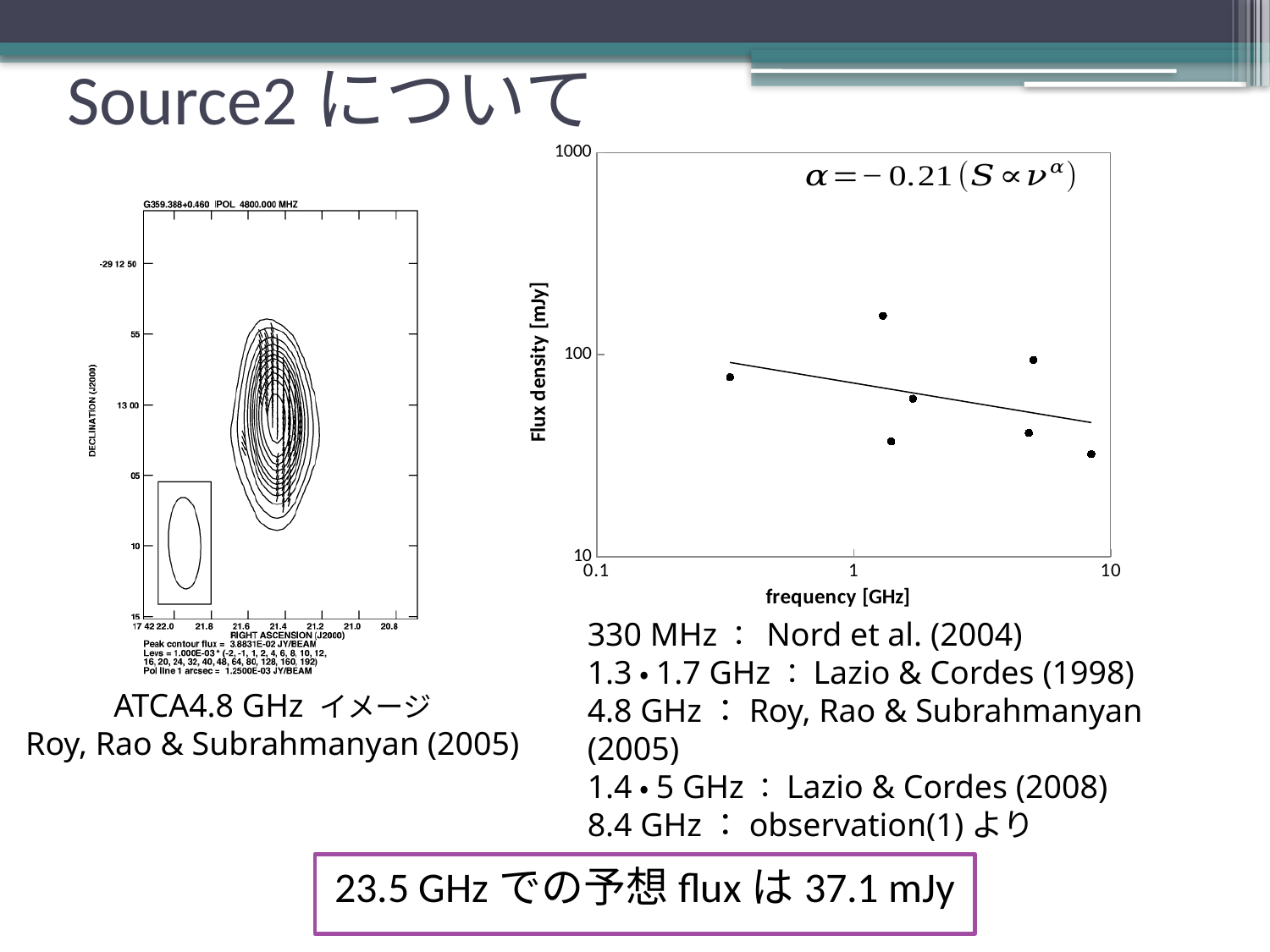
In the flux density versus frequency chart, is the rightmost data point (at 8.4 GHz) greater or less than 100 mJy? less In the flux density versus frequency chart, is the leftmost data point (at 330 MHz) greater or less than 100 mJy? less In the flux density versus frequency chart, is the highest data point greater or less than 100 mJy? greater In the flux density versus frequency chart, which has the larger flux density: the leftmost data point or the rightmost data point? The leftmost data point In the flux density versus frequency chart, does the fitted line rise or fall as frequency increases? Falls What is the label of the vertical axis of the flux density versus frequency chart? Flux density [mJy] How many data points are plotted in the flux density versus frequency chart? 7 What value of the spectral index α is printed on the flux density versus frequency chart? −0.21 What kind of chart is the plot of flux density against frequency on the right of the slide? Scatter plot with a fitted line